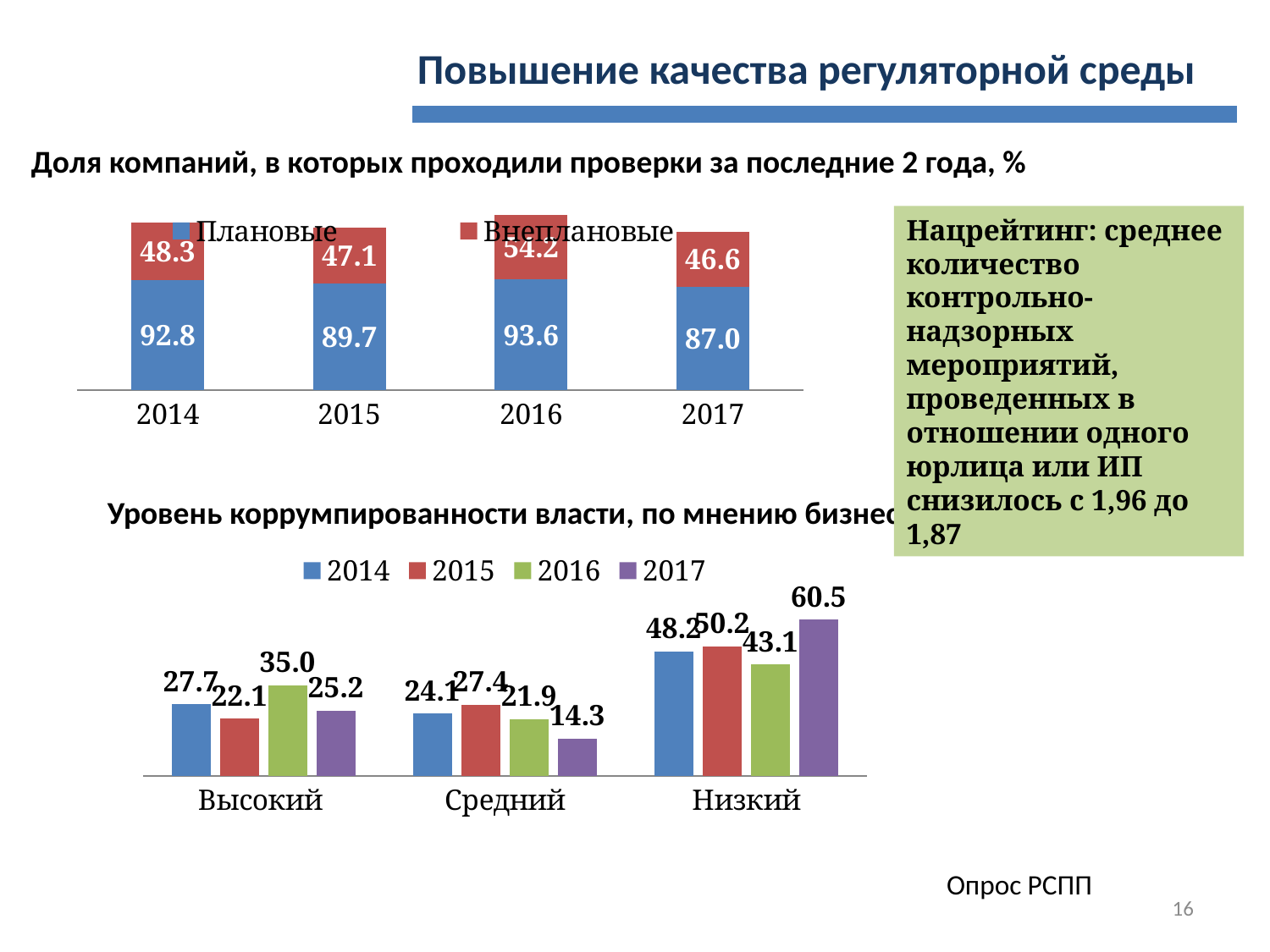
In the top chart (Доля компаний, в которых проходили проверки), what is the difference between the Плановые values for 2014 and 2015? 3.1 In the bottom chart (Уровень коррумпированности власти), which is larger in the Низкий category: 2015 or 2016? 2015 In the top chart (Доля компаний, в которых проходили проверки), which year has the lowest value for Плановые? 2017 In the top chart (Доля компаний, в которых проходили проверки за последние 2 года), what is the value for Плановые in 2016? 93.6 In the top chart (Доля компаний, в которых проходили проверки), which year has the highest value for Внеплановые? 2016 In the top chart (Доля компаний, в которых проходили проверки), what is the value for Внеплановые in 2017? 46.6 In the bottom chart (Уровень коррумпированности власти), what is the value for 2016 in the Высокий category? 35.0 In the bottom chart (Уровень коррумпированности власти), which year has the lowest value in the Средний category? 2017 What kind of chart is the top chart (Доля компаний, в которых проходили проверки)? Stacked bar chart In the bottom chart (Уровень коррумпированности власти), how many categories are shown on the x axis? 3 In the bottom chart (Уровень коррумпированности власти), what is the value for 2017 in the Низкий category? 60.5 In the top chart (Доля компаний, в которых проходили проверки), how many series does the legend list? 2